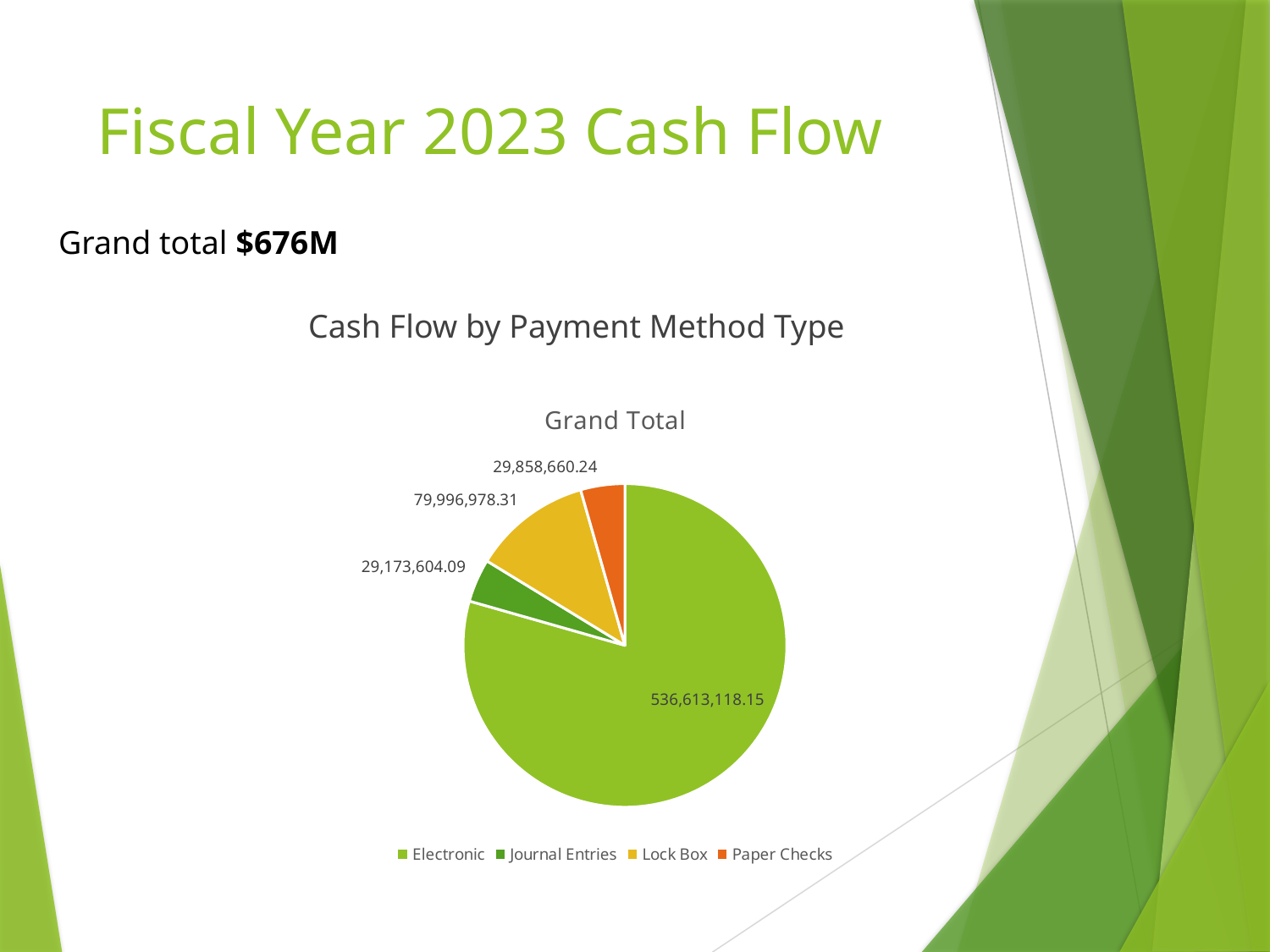
Which payment method type has the largest slice in the pie chart? Electronic Which is larger in the pie chart, Paper Checks or Journal Entries? Paper Checks What is the title shown directly above the pie chart? Grand Total How many entries does the pie chart's legend list? 4 What is the value of the Paper Checks slice in the pie chart? 29,858,660.24 How many slices does the pie chart have? 4 What is the difference between the Lock Box value and the Paper Checks value in the pie chart? 50,138,318.07 Which payment method type has the smallest slice in the pie chart? Journal Entries What is the value of the Journal Entries slice in the pie chart? 29,173,604.09 What type of chart is shown on the slide? Pie chart What is the value of the Lock Box slice in the pie chart? 79,996,978.31 What is the value of the Electronic slice in the pie chart? 536,613,118.15